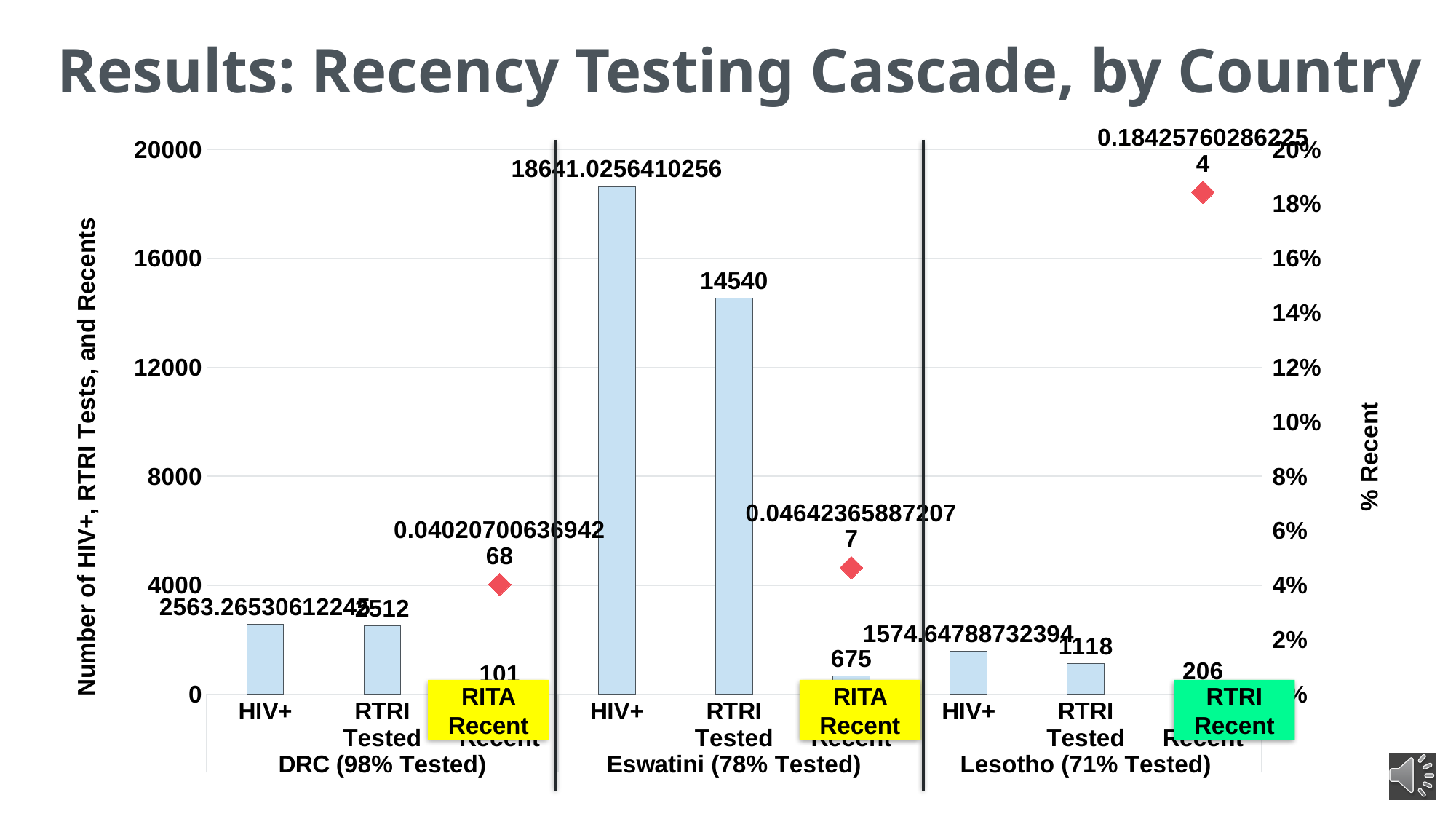
What is the value of the Recent bar for Lesotho? 206 What is the difference between the RTRI Tested and Recent values for Eswatini? 13865 What is the value of the Recent bar for Eswatini? 675 How many countries are shown on the chart? 3 Which is larger, the RTRI Tested value for DRC or for Lesotho? DRC What is the value of the RTRI Tested bar for Lesotho? 1118 Which country has the highest HIV+ bar? Eswatini What is the value of the RTRI Tested bar for DRC? 2512 What is the value of the RTRI Tested bar for Eswatini? 14540 What is the title of the right-hand vertical axis? % Recent Is the % Recent marker for Lesotho greater or less than 16%? greater Is the HIV+ value for Eswatini greater or less than 16000? greater